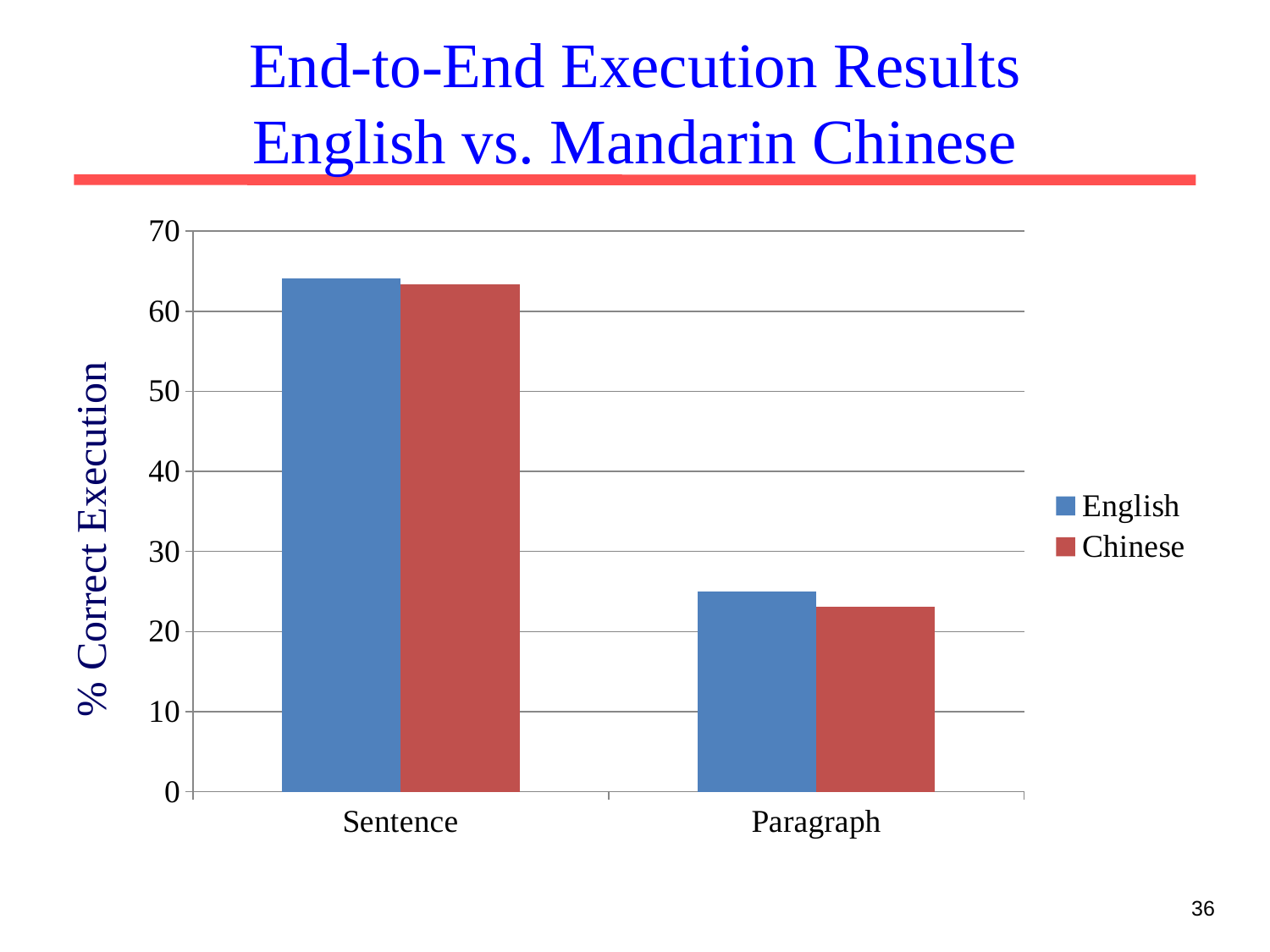
What kind of chart is shown on the slide? bar chart What is the label on the y axis? % Correct Execution Is the value for Chinese in the Paragraph category greater or less than 30? less Which category has the highest value for the Chinese series? Sentence Is the value for Chinese in the Sentence category greater or less than 50? greater Is the value for English in the Paragraph category greater or less than 20? greater For the English series, which category has the larger value, Sentence or Paragraph? Sentence Which category has the lowest value for the English series? Paragraph How many series does the legend list? 2 Do the values rise or fall from Sentence to Paragraph for both series? fall How many categories are shown on the x axis? 2